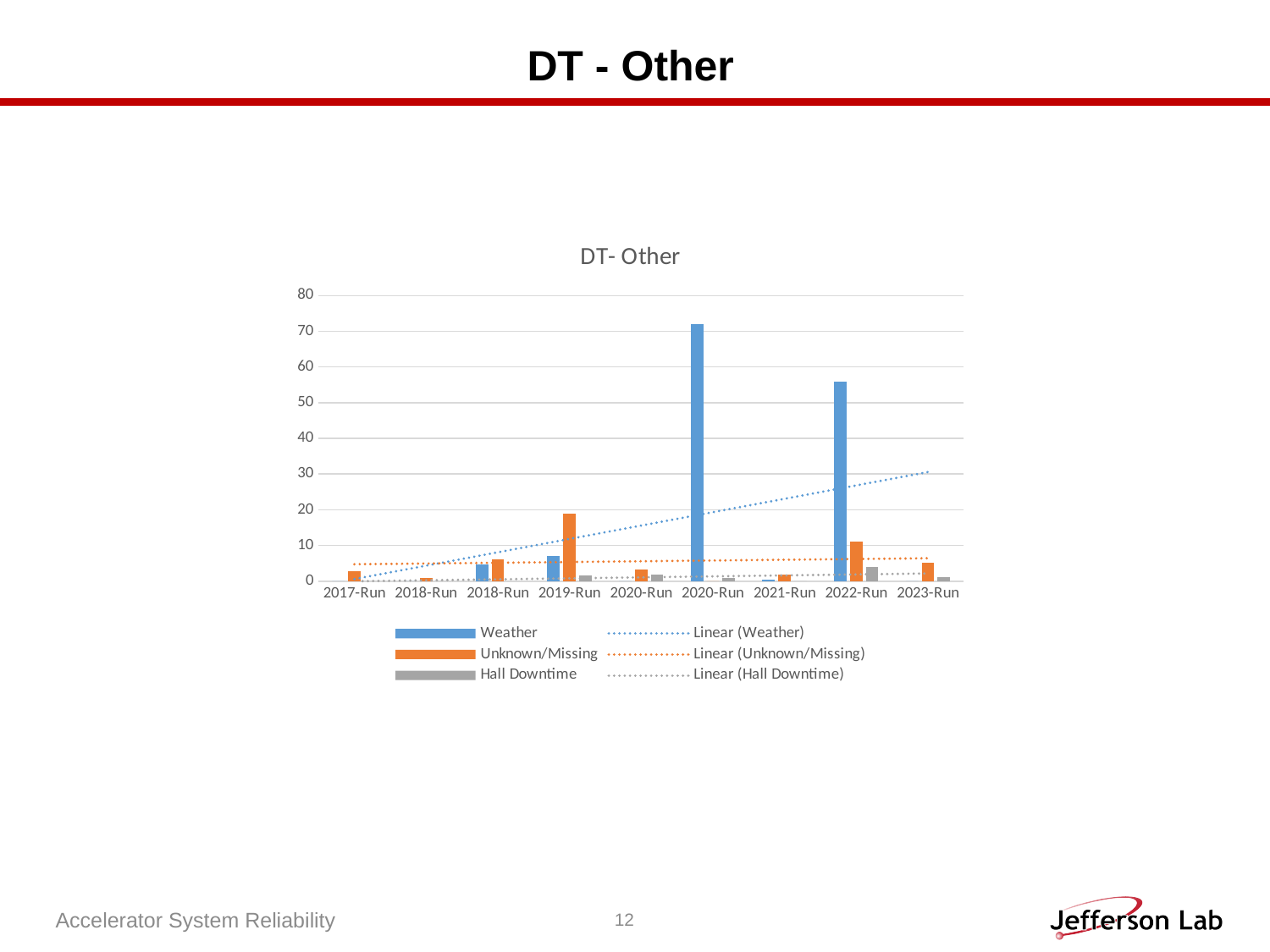
How many categories are shown along the x axis of the chart? 9 How many entries does the chart's legend list? 6 Is the Hall Downtime value for 2022-Run greater or less than 10? less Which colour represents the Weather series in the chart? blue For 2022-Run, which is larger: the Weather value or the Unknown/Missing value? Weather Is the Weather value for 2022-Run greater or less than 50? greater What is the title of the chart? DT- Other Is the Unknown/Missing value for 2019-Run greater or less than 10? greater Does the Linear (Weather) trendline rise or fall from left to right? rise Which category has the highest Weather value? 2020-Run What kind of chart is shown on the slide? bar chart